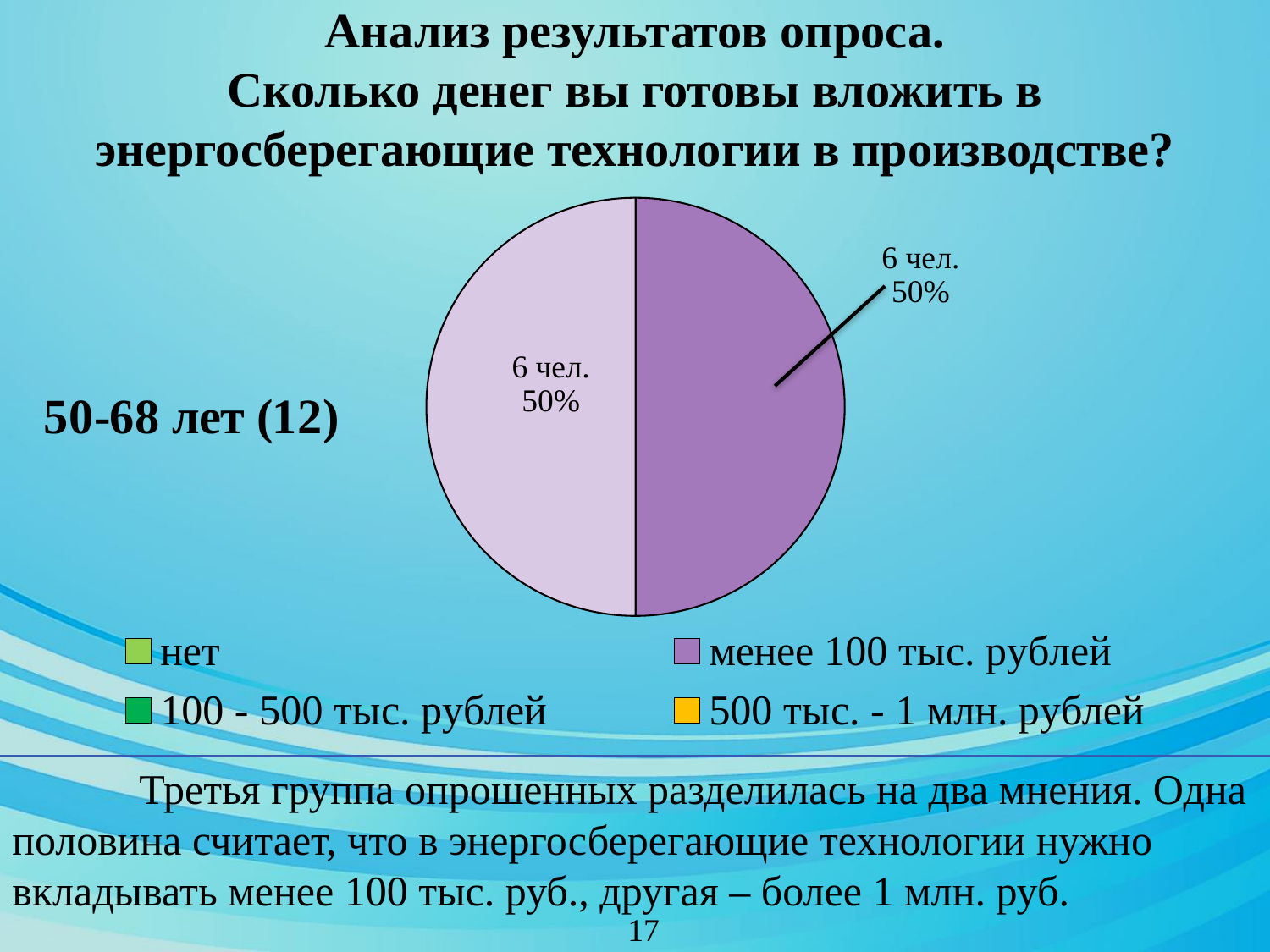
Are the two slices of the pie equal in size? yes What kind of chart is shown on the slide? pie chart What percentage is shown on the darker purple slice on the right? 50% What share of the pie does the 'менее 100 тыс. рублей' slice represent? 50% What colour is the legend marker for 'нет'? light green How many entries does the legend list? 4 How many people does the darker purple slice on the right represent? 6 чел. What is the total number of people represented by the two slices of the pie? 12 What is the difference in number of people between the two slices of the pie? 0 Which age group does the pie chart describe, according to the label to the left of it? 50-68 лет (12) How many people are in the 'менее 100 тыс. рублей' slice? 6 чел. How many slices does the pie chart have? 2